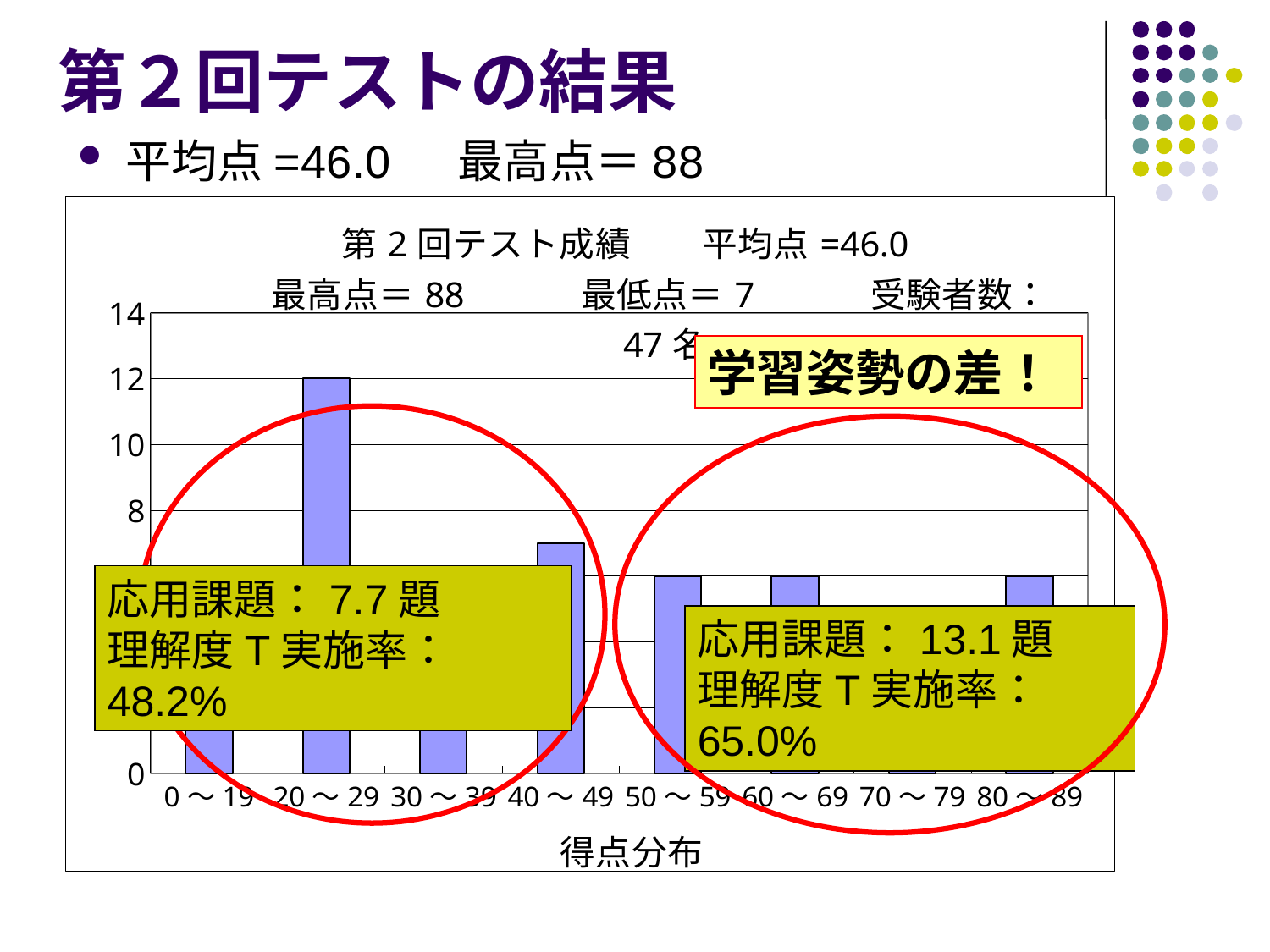
What kind of chart is shown on the slide? bar chart What is the x-axis title of the chart? 得点分布 Is the value for the 40～49 score range greater or less than 8? less Is the value for the 40～49 score range greater or less than 6? greater Which has the larger value, the 40～49 range or the 50～59 range? 40～49 What is the value of the bar for the 20～29 score range? 12 How many score-range categories are shown on the x axis of the chart? 8 Which has the larger value, the 20～29 range or the 40～49 range? 20～29 Is the value for the 50～59 score range greater or less than 4? greater Which score range has the highest bar in the chart? 20～29 What is the highest value shown on the chart's y axis? 14